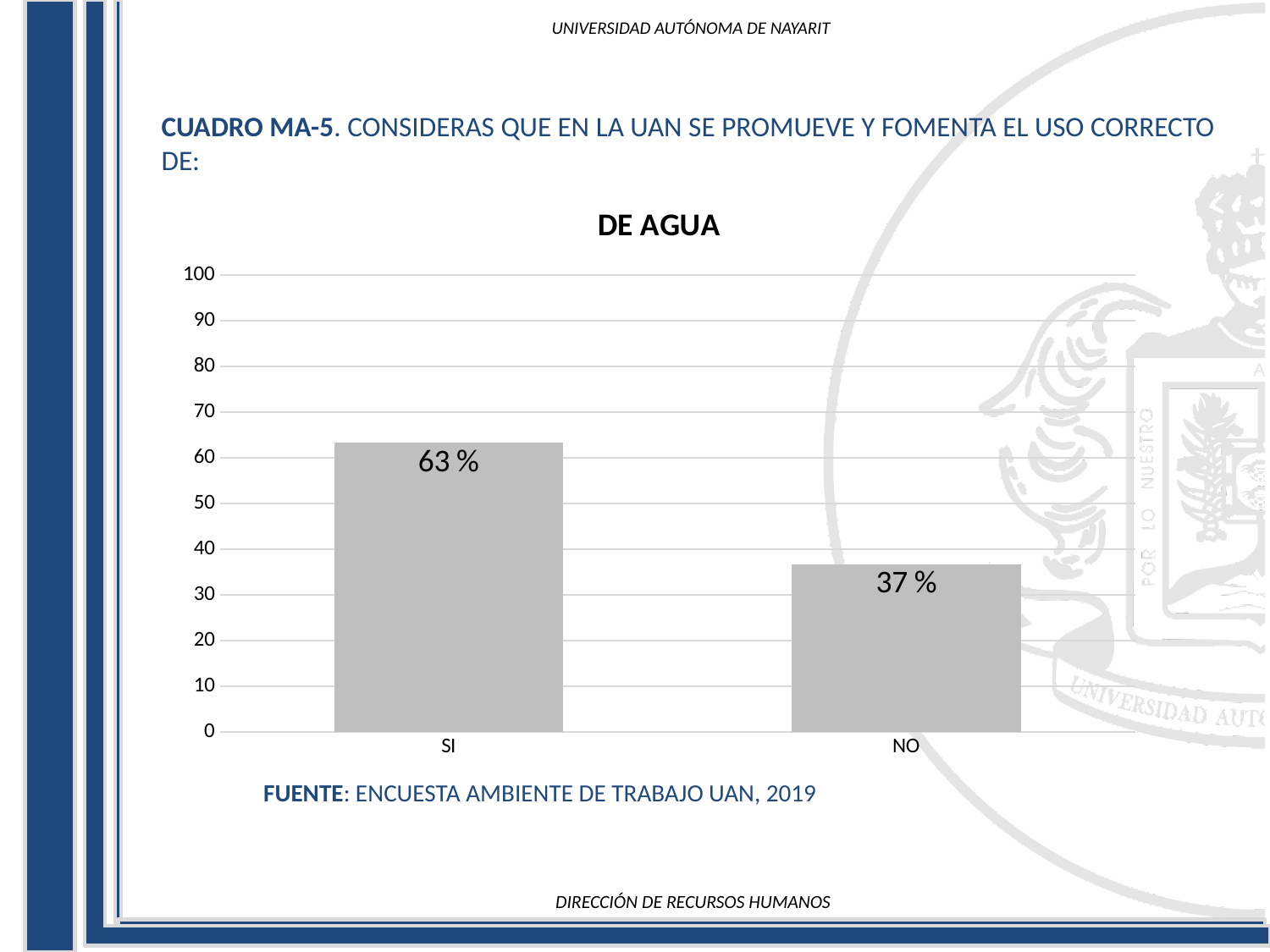
What is the value for NO? 37 % What is the value for SI? 63 % What kind of chart is shown? bar chart What is the title of the chart? DE AGUA Is the value for NO greater or less than 40? less Is the value for SI greater or less than 50? greater How many categories are shown on the x axis? 2 Which category has the lowest value? NO Which category has the highest value? SI What is the highest value shown on the y axis? 100 Which is larger, the value for SI or the value for NO? SI What is the difference between the values for SI and NO? 26 %